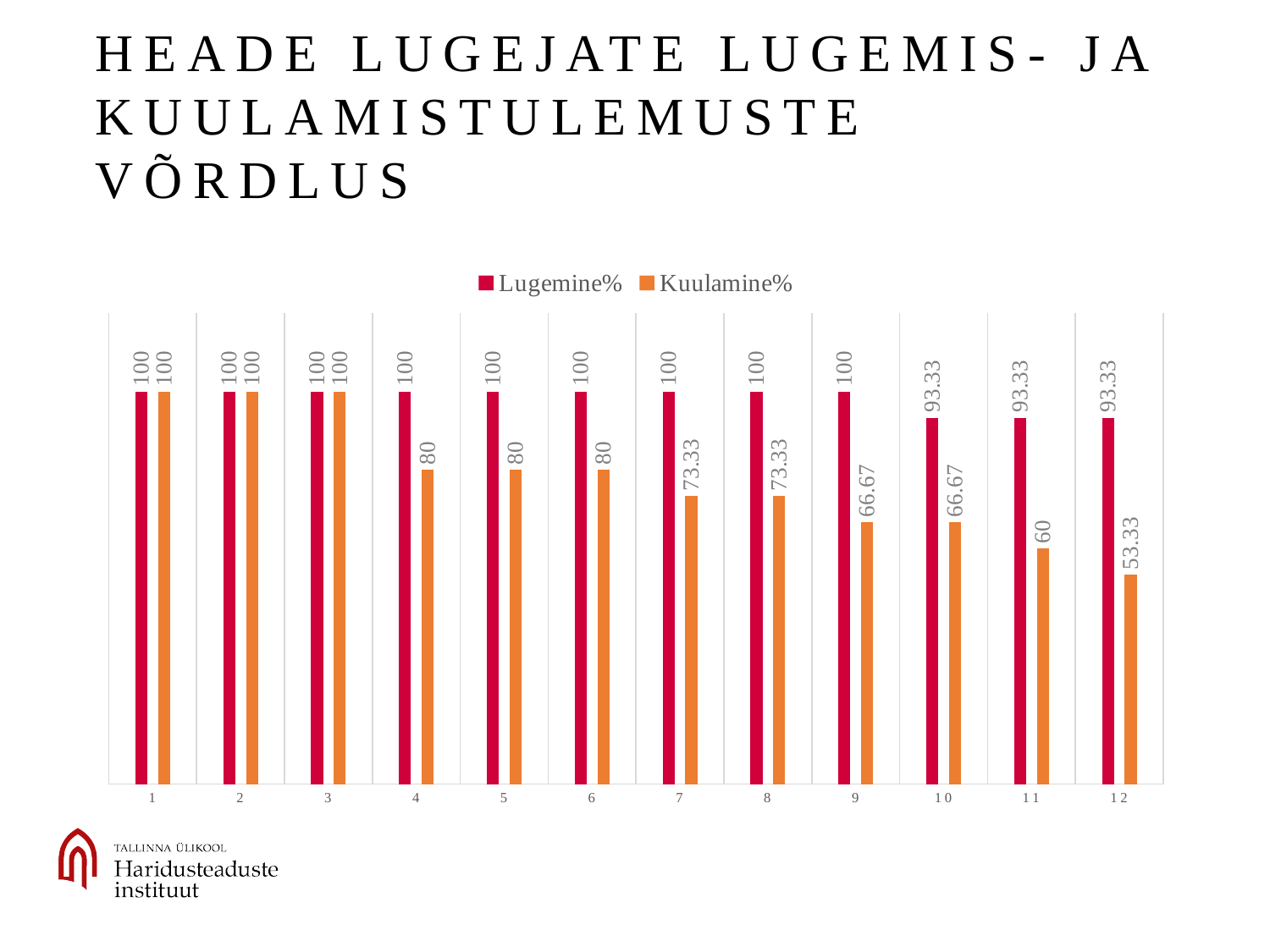
Which is larger for category 5: the Lugemine% value or the Kuulamine% value? Lugemine% How many series does the legend list? 2 Do the Kuulamine% values rise or fall from category 1 to category 12? Fall How many categories are shown on the x axis? 12 What is the Kuulamine% value for category 12? 53.33 Which category has the lowest Kuulamine% value? 12 What is the difference between the Kuulamine% values for category 4 and category 9? 13.33 What kind of chart is shown on the slide? Bar chart What is the Lugemine% value for category 10? 93.33 What is the difference between the Lugemine% and Kuulamine% values for category 11? 33.33 What is the Kuulamine% value for category 7? 73.33 Which series is shown in orange in the legend? Kuulamine%